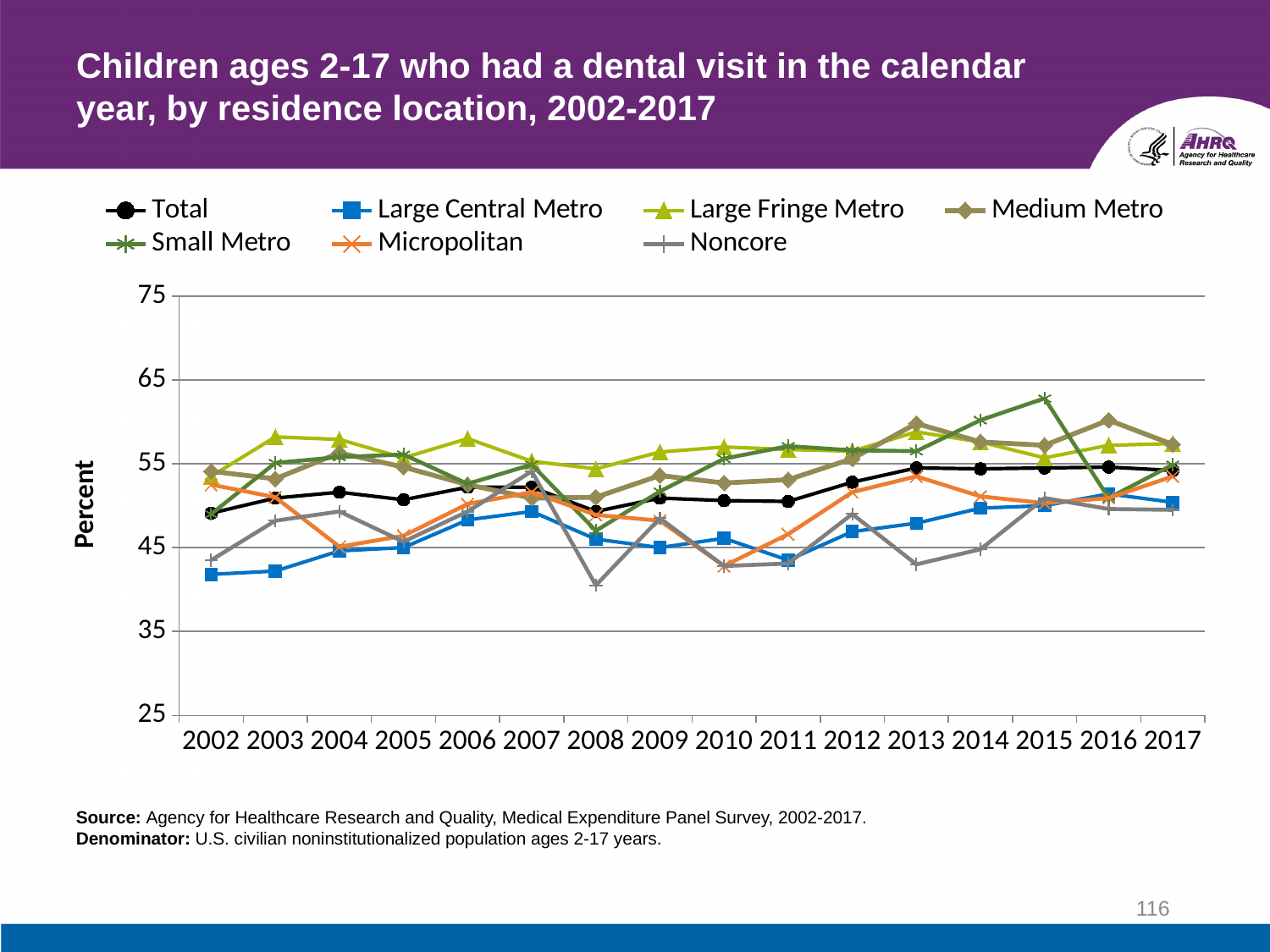
In 2002, which is higher: Large Fringe Metro or Large Central Metro? Large Fringe Metro How many series does the legend list? 7 Is the value for Noncore in 2008 greater or less than 45? less Does the Large Central Metro line rise or fall overall from 2002 to 2017? rise How many years are plotted along the x axis? 16 Which residence location has the lowest value in 2008? Noncore What kind of chart is shown on the slide? line chart What is the label on the y axis? Percent Which residence location has the highest value in 2015? Small Metro Is the value for Large Fringe Metro in 2003 greater or less than 55? greater Is the value for Large Central Metro in 2002 greater or less than 45? less